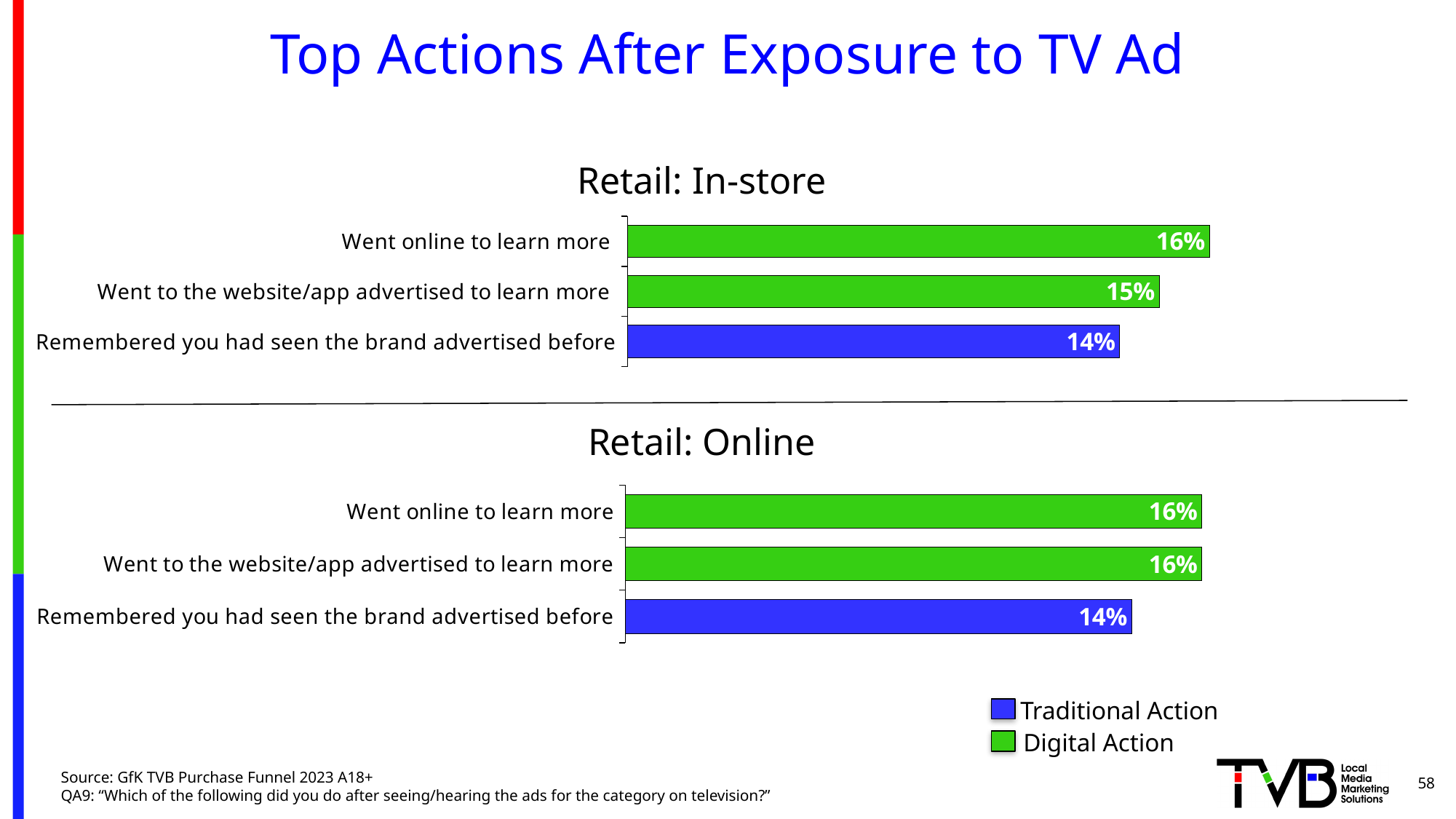
In the Retail: In-store chart, which action has the highest value? Went online to learn more In the Retail: In-store chart, what is the difference between "Went online to learn more" and "Remembered you had seen the brand advertised before"? 2% In the Retail: In-store chart, which action has the lowest value? Remembered you had seen the brand advertised before In the Retail: Online chart, what is the value for "Went to the website/app advertised to learn more"? 16% What kind of chart is the Retail: In-store chart? Bar chart In the Retail: In-store chart, which is larger: "Went to the website/app advertised to learn more" or "Remembered you had seen the brand advertised before"? Went to the website/app advertised to learn more In the Retail: In-store chart, what is the value for "Remembered you had seen the brand advertised before"? 14% In the Retail: Online chart, which action has the lowest value? Remembered you had seen the brand advertised before How many actions are shown in the Retail: Online chart? 3 In the Retail: In-store chart, what is the value for "Went online to learn more"? 16% In the Retail: Online chart, what is the value for "Remembered you had seen the brand advertised before"? 14% How many series does the legend list? 2